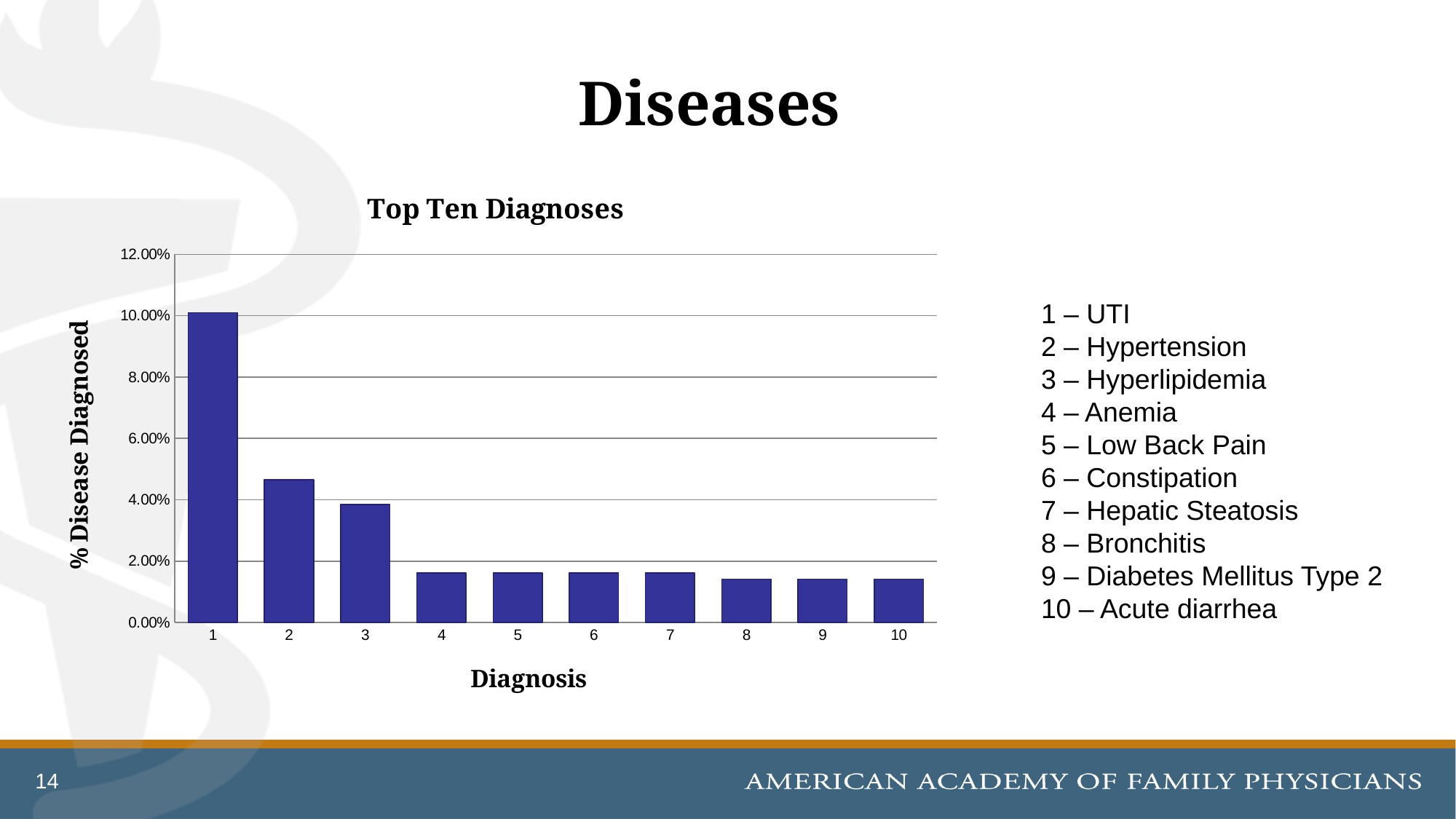
What is the label of the vertical axis? % Disease Diagnosed How many diagnoses (bars) are plotted in the chart? 10 What kind of chart is shown on the slide? bar chart Is the value for diagnosis 3 greater or less than 2.00%? greater What is the title of the chart? Top Ten Diagnoses Is the value for diagnosis 5 greater or less than 2.00%? less Is the value for diagnosis 1 greater or less than 8.00%? greater Do the values generally rise or fall from diagnosis 1 to diagnosis 10? fall Which diagnosis number has the highest % Disease Diagnosed? 1 Which has a larger % Disease Diagnosed, diagnosis 3 or diagnosis 4? 3 Which has a larger % Disease Diagnosed, diagnosis 2 or diagnosis 3? 2